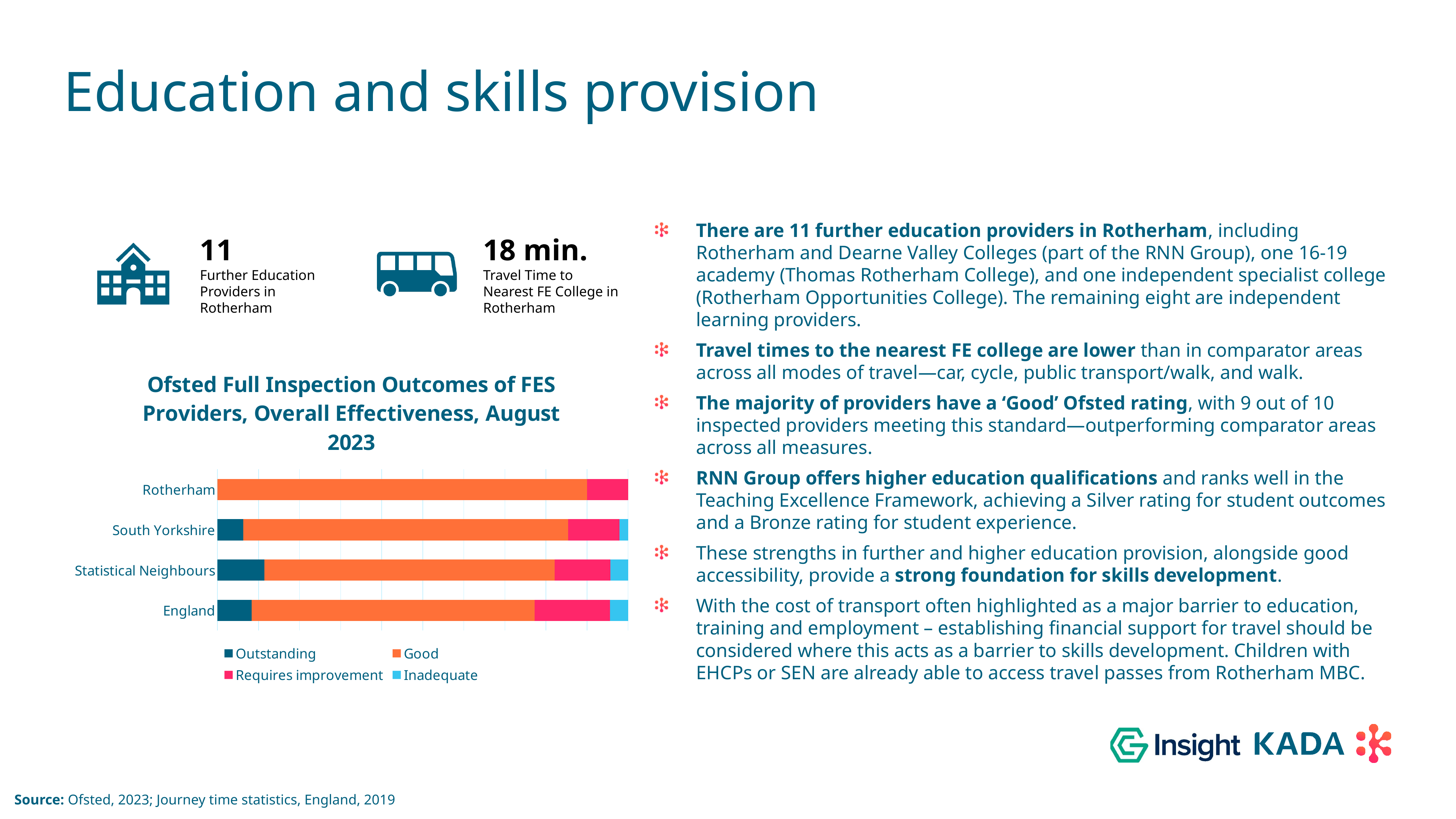
What is the title of the chart? Ofsted Full Inspection Outcomes of FES Providers, Overall Effectiveness, August 2023 How many categories (areas) are plotted on the chart? 4 What kind of chart is shown on the slide? Stacked bar chart Which area shows no 'Outstanding' segment at all? Rotherham How many series does the chart legend list? 4 Is the 'Outstanding' segment larger for Statistical Neighbours or for South Yorkshire? Statistical Neighbours Which area has the largest 'Good' share of the bar? Rotherham Which area shows no 'Inadequate' segment at all? Rotherham Which area has the largest 'Outstanding' segment? Statistical Neighbours Which area has the largest 'Requires improvement' segment? England Is the 'Good' share larger for Rotherham or for England? Rotherham Which colour represents 'Good' in the chart legend? Orange